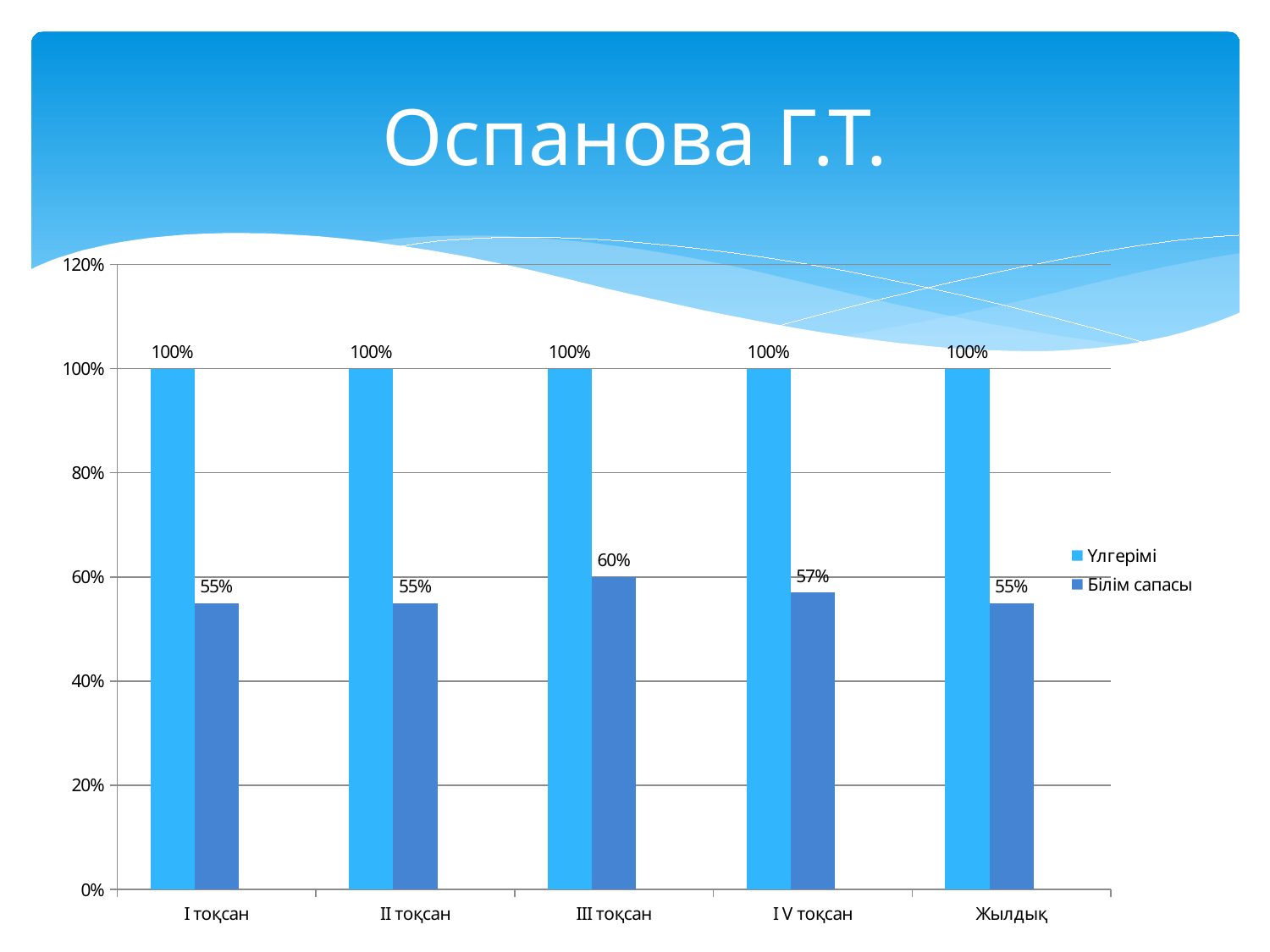
Which is larger, Білім сапасы for III тоқсан or for I тоқсан? III тоқсан What is the difference between the Білім сапасы values for III тоқсан and IV тоқсан? 3% What is the value of Білім сапасы for III тоқсан? 60% Which category has the highest Білім сапасы value? III тоқсан What is the difference between Үлгерімі and Білім сапасы for II тоқсан? 45% What is the value of Үлгерімі for I тоқсан? 100% What kind of chart is shown on the slide? bar chart How many series does the legend list? 2 What is the value of Білім сапасы for IV тоқсан? 57% What is the title of the slide? Оспанова Г.Т. What is the value of Білім сапасы for Жылдық? 55% How many categories are shown on the x axis? 5